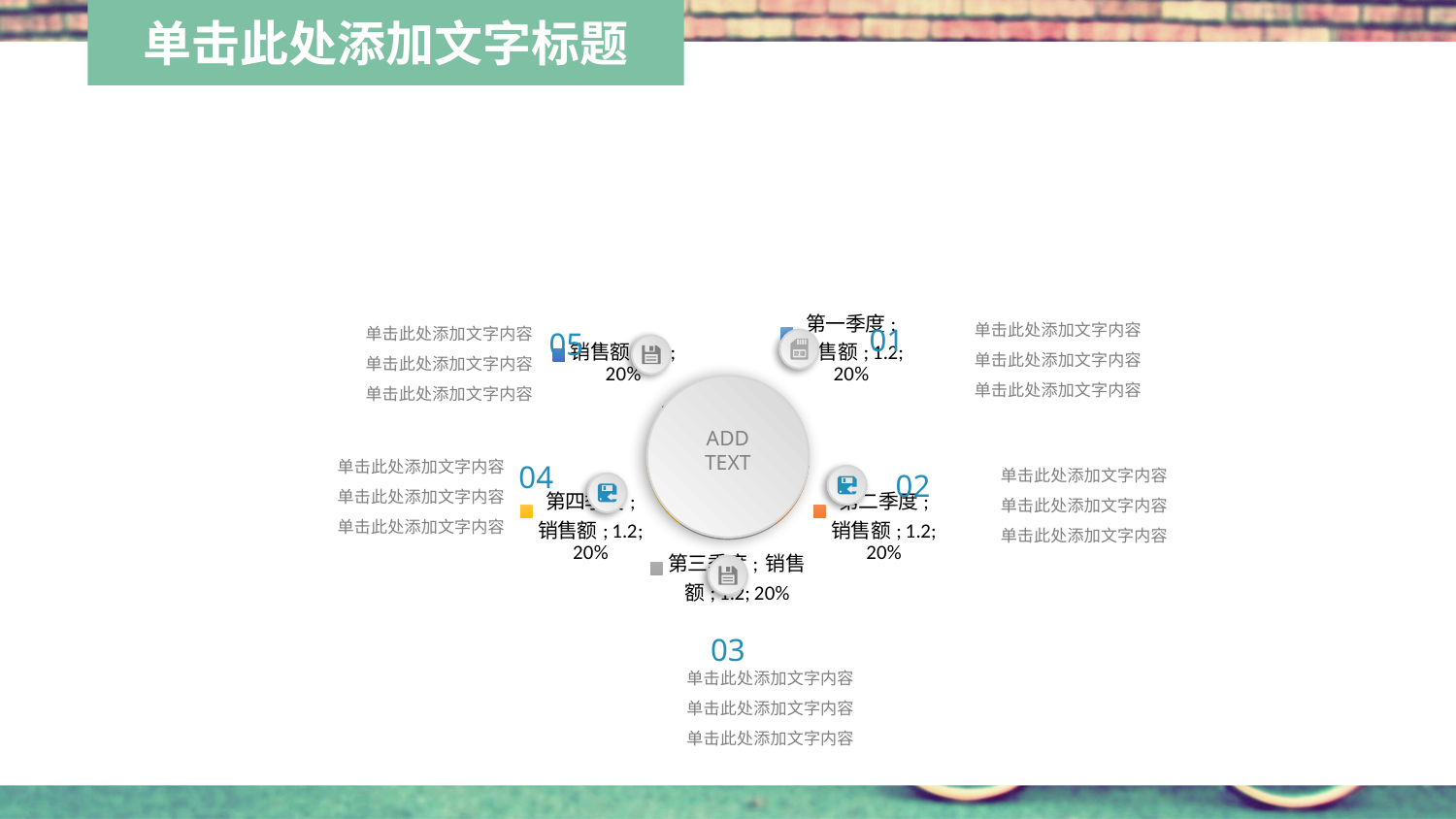
How many data labels showing 20% are visible on the chart? 5 What value is shown in the data label for 第四季度? 1.2 What series name appears in the data labels of the chart? 销售额 What value is shown in the data label for 第三季度? 1.2 What percentage is shown in the data label for 第四季度? 20% What percentage is shown in the data label for 第三季度? 20% What value is shown in the data label for 第一季度? 1.2 What is the difference between the values for 第一季度 and 第二季度? 0 What percentage share is shown for 第二季度? 20%